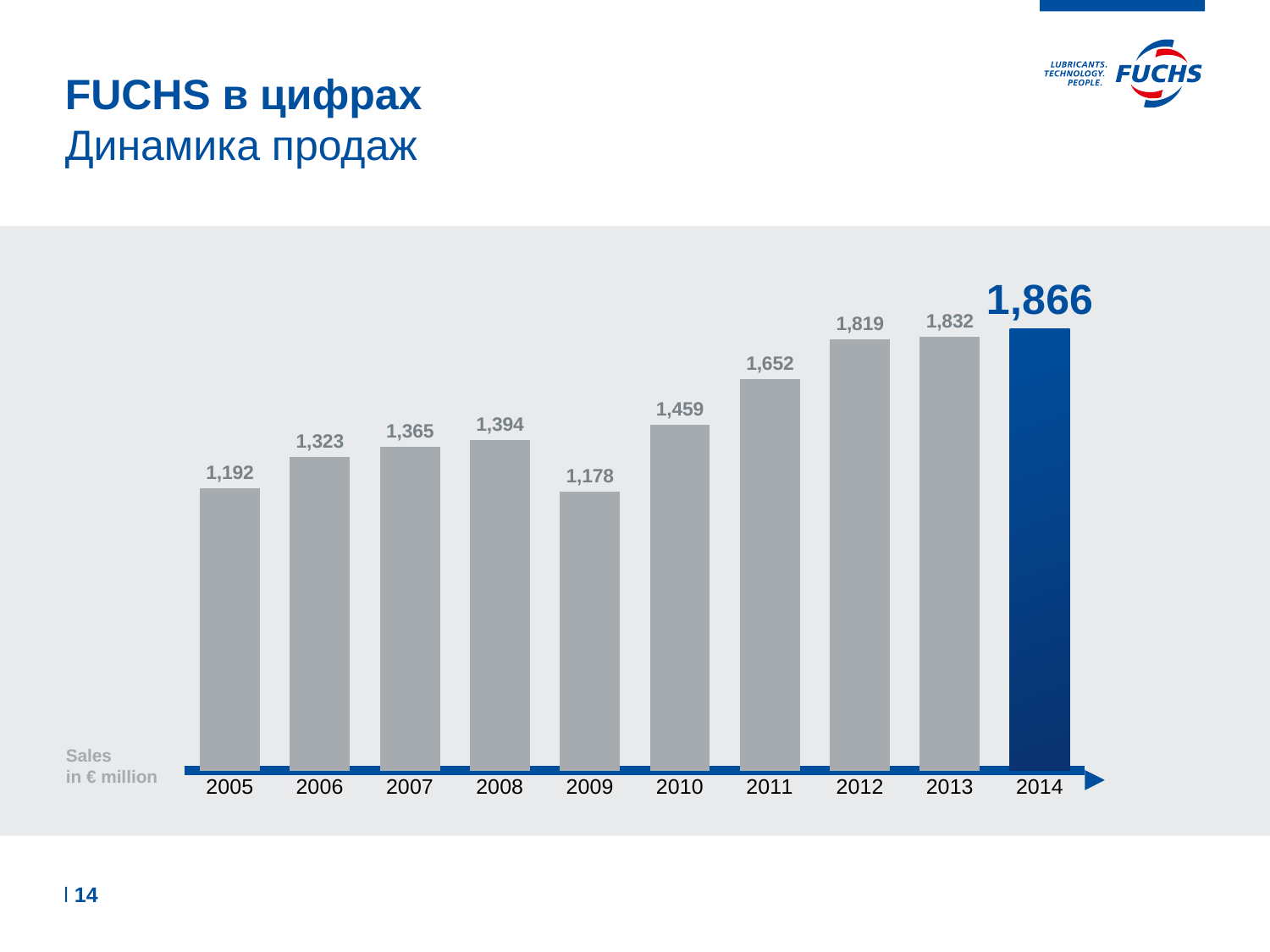
What is the sales value for 2009? 1,178 What is the sales value for 2014? 1,866 Which year has higher sales, 2008 or 2009? 2008 In what unit are the sales values given? € million What is the difference in sales between 2014 and 2013? 34 Which year has the lowest sales? 2009 How many years are shown on the chart? 10 Which year has the highest sales? 2014 Do sales rise or fall from 2009 to 2014? rise What is the difference in sales between 2011 and 2010? 193 What is the sales value for 2005? 1,192 What kind of chart is shown on the slide? bar chart